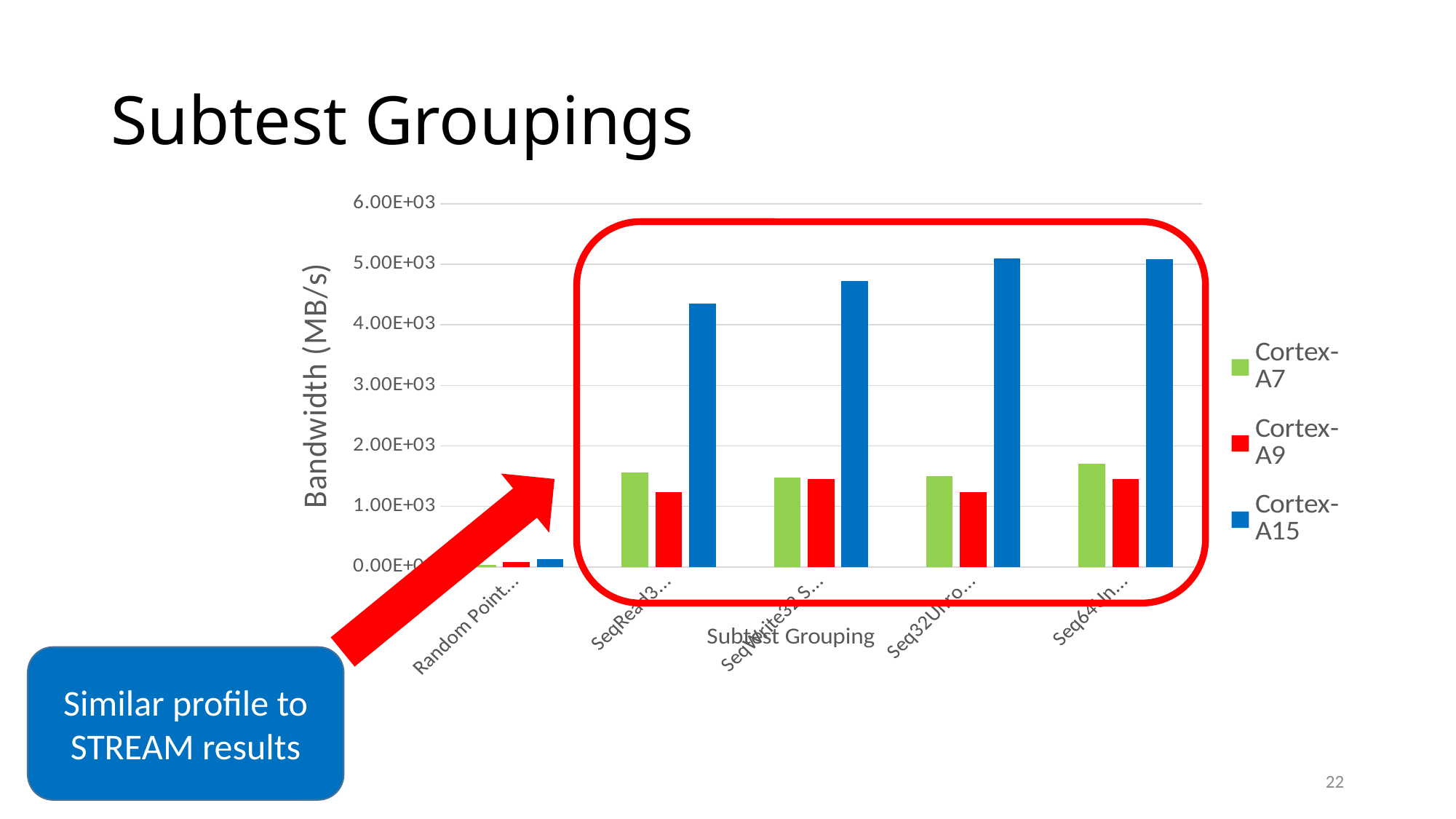
How many series does the legend list? 3 What is the title of the vertical axis? Bandwidth (MB/s) Which series has the highest value in the last category (Seq64)? Cortex-A15 In the second category (SeqRead), which is larger: the Cortex-A7 value or the Cortex-A9 value? Cortex-A7 How many subtest grouping categories are plotted along the x axis? 5 Is the Cortex-A7 value for the last category (Seq64) greater or less than 2.00E+03? less Which category has the lowest Cortex-A15 value? Random Point (the first category) Is the Cortex-A9 value for the first category (Random Point) greater or less than 1.00E+03? less What kind of chart is shown on the slide? Bar chart Is the Cortex-A15 value for the second category (SeqRead) greater or less than 4.00E+03? greater Which series is drawn in blue according to the legend? Cortex-A15